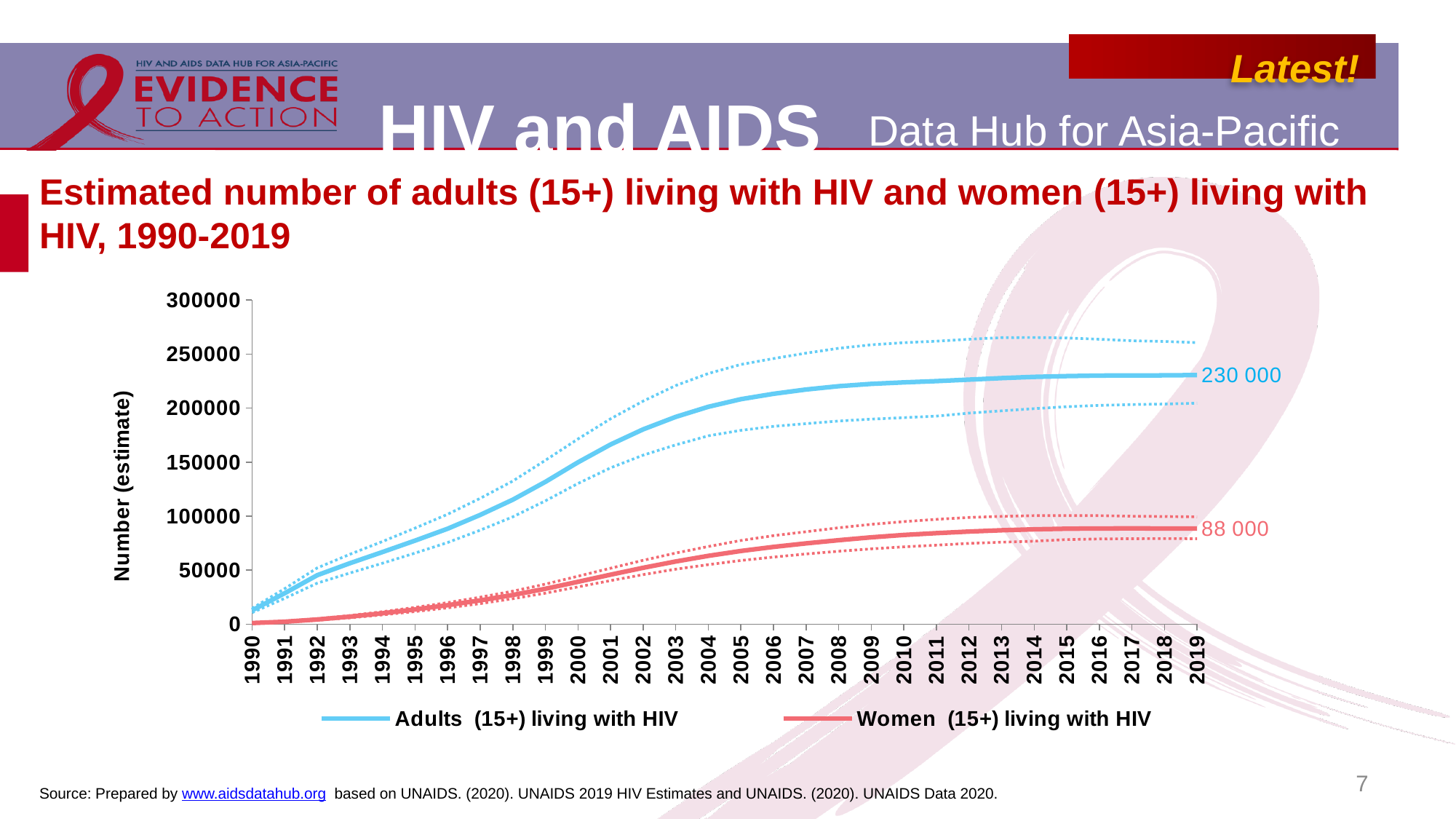
What is the estimated number of women (15+) living with HIV in 2019? 88 000 How many series does the chart legend list? 2 How many years are shown on the x axis of the chart? 30 Is the value for adults (15+) living with HIV in 1995 greater or less than 100000? less What is the estimated number of adults (15+) living with HIV in 2019? 230 000 What is the difference between the 2019 values for adults (15+) and women (15+) living with HIV? 142 000 Is the value for adults (15+) living with HIV in 2000 greater or less than 100000? greater Is the value for women (15+) living with HIV in 2000 greater or less than 50000? less What kind of chart is shown on the slide? Line chart Does the number of adults (15+) living with HIV rise or fall from 1990 to 2019? Rise In 2019, which series has the larger value: adults (15+) living with HIV or women (15+) living with HIV? Adults (15+) living with HIV